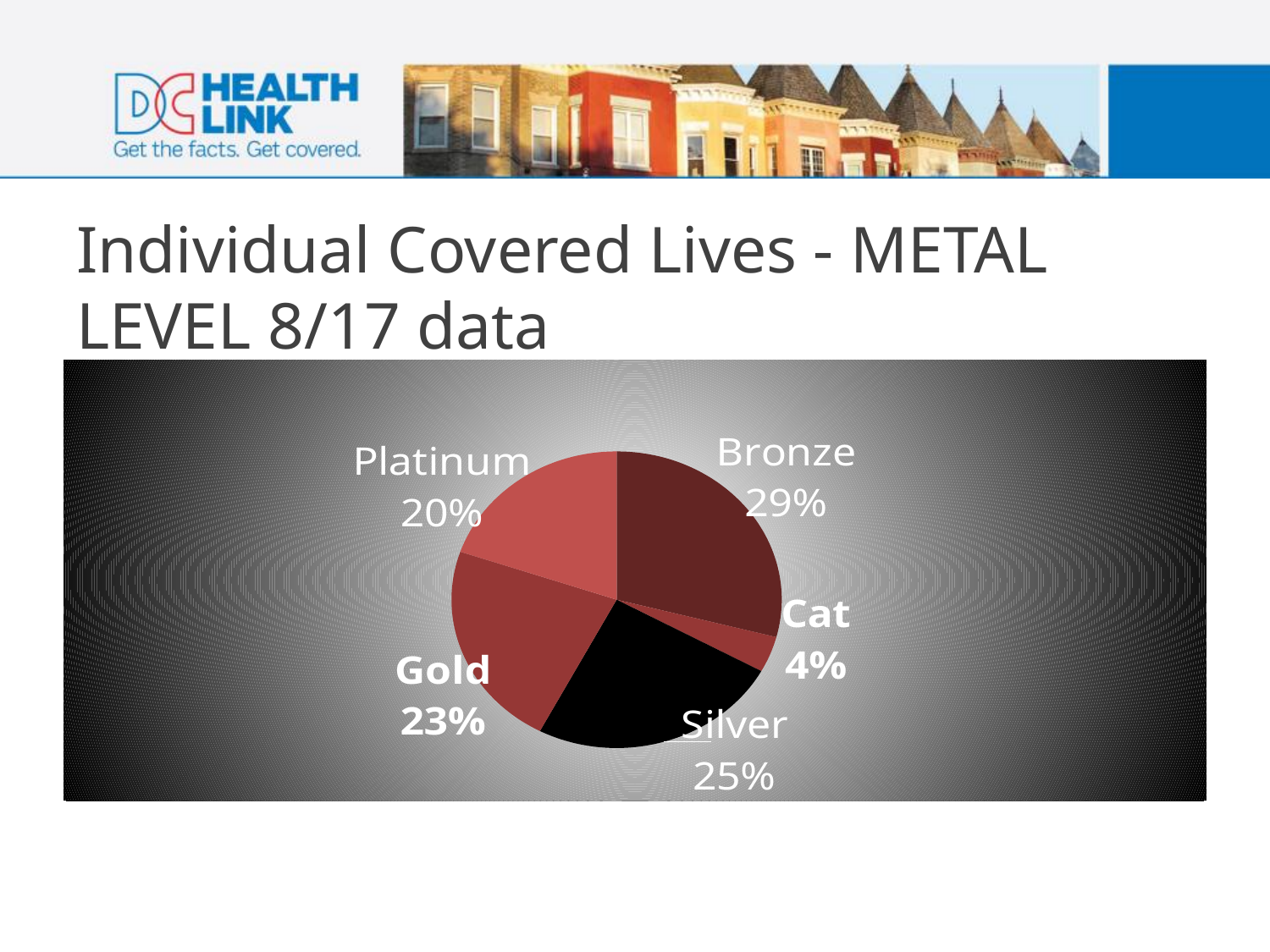
What share of individual covered lives is Gold? 23% What share of individual covered lives is Bronze? 29% What share of individual covered lives is Silver? 25% What share of individual covered lives is Platinum? 20% Which has a larger share, Silver or Gold? Silver What share of individual covered lives is Cat? 4% What is the title of the slide containing the chart? Individual Covered Lives - METAL LEVEL 8/17 data How many percentage points larger is the Bronze share than the Platinum share? 9 How many metal level categories are shown in the pie chart? 5 What type of chart is shown on the slide? Pie chart Which metal level has the smallest share of individual covered lives? Cat Which metal level has the largest share of individual covered lives? Bronze